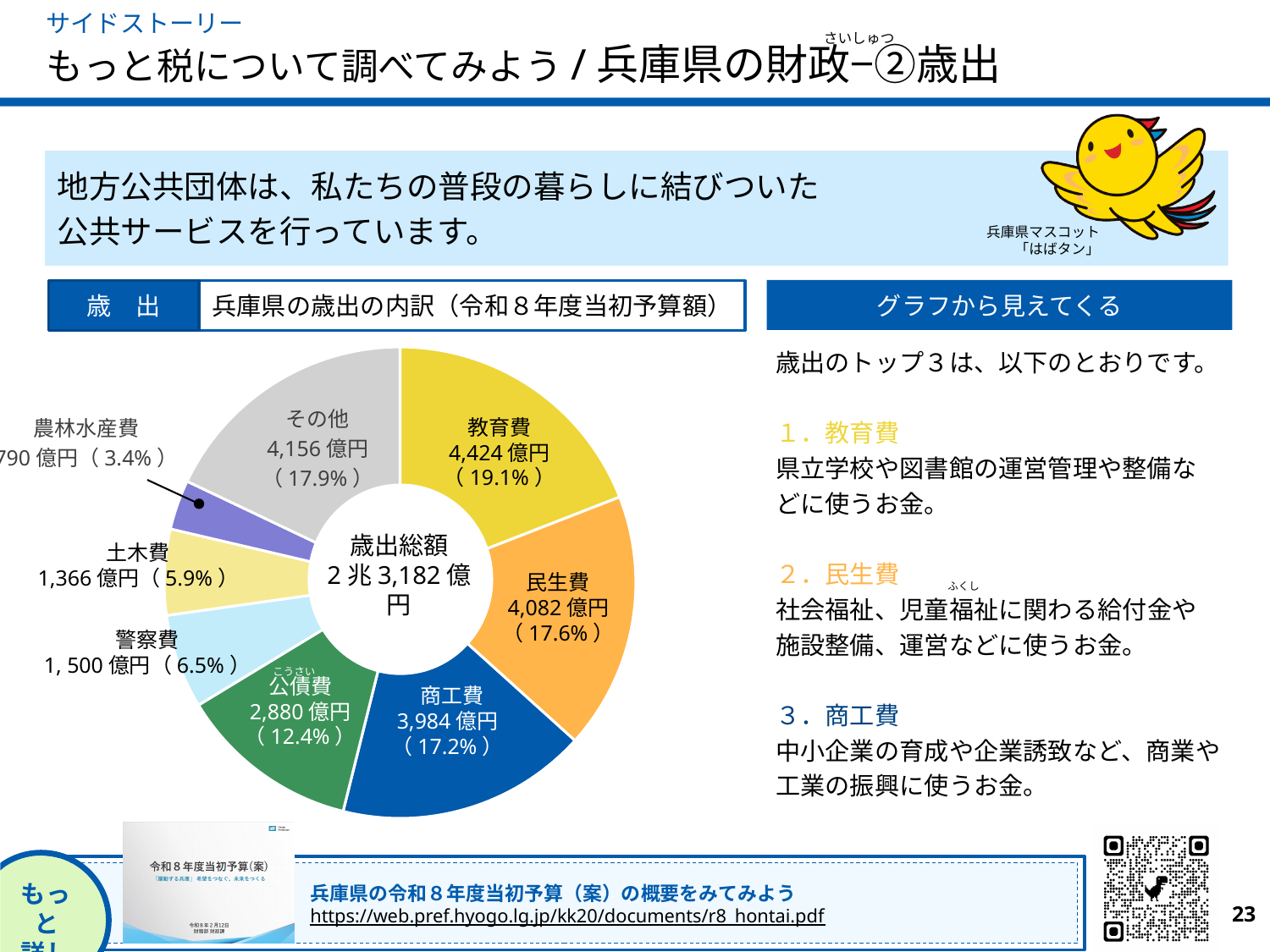
教育費と民生費の歳出額の差はいくらですか？ 342 億円 公債費の割合は何％ですか？ 12.4% 「その他」を除いて、歳出額が最も大きい費目はどれですか？ 教育費 歳出総額はいくらですか？ 2 兆 3,182 億円 民生費の割合は何％ですか？ 17.6% グラフには費目がいくつ示されていますか？ 8 このグラフのタイトルは何ですか？ 兵庫県の歳出の内訳（令和８年度当初予算額） 教育費の歳出額はいくらですか？ 4,424 億円 警察費と土木費では、どちらの歳出額が大きいですか？ 警察費 商工費の歳出額はいくらですか？ 3,984 億円 このグラフはどの種類のグラフですか？ 円グラフ（ドーナツグラフ） 歳出額が最も小さい費目はどれですか？ 農林水産費